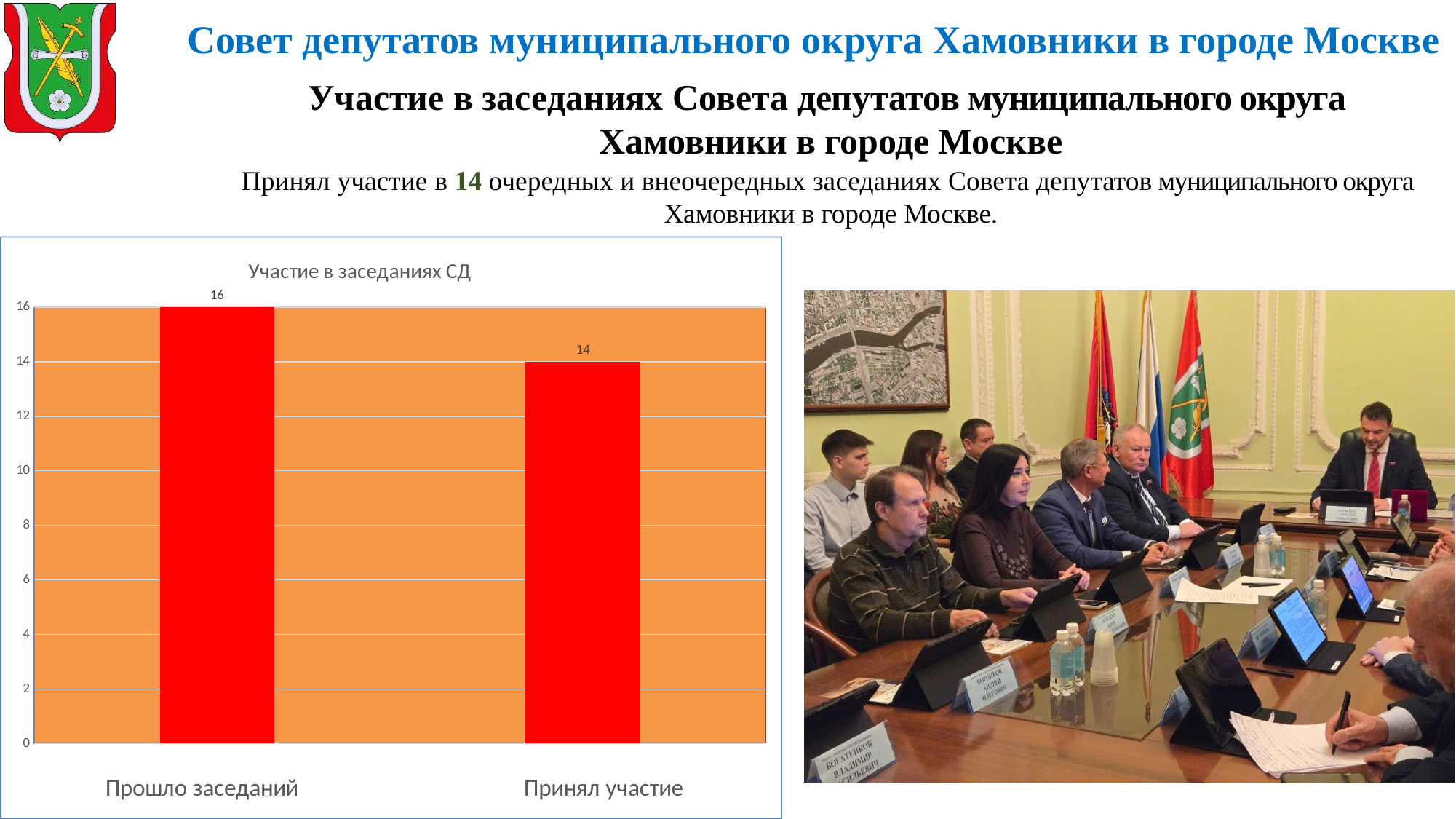
What is the difference between the values for "Прошло заседаний" and "Принял участие"? 2 What is the value for "Прошло заседаний"? 16 What colour are the bars in the chart? red What kind of chart is shown on the slide? bar chart What is the value for "Принял участие"? 14 Is the value for "Принял участие" greater or less than 10? greater How many categories are shown on the chart? 2 Do the values rise or fall from left to right along the x axis? fall What is the title of the chart? Участие в заседаниях СД Which is larger, the value for "Прошло заседаний" or for "Принял участие"? Прошло заседаний Which category has the highest value? Прошло заседаний Which category has the lowest value? Принял участие